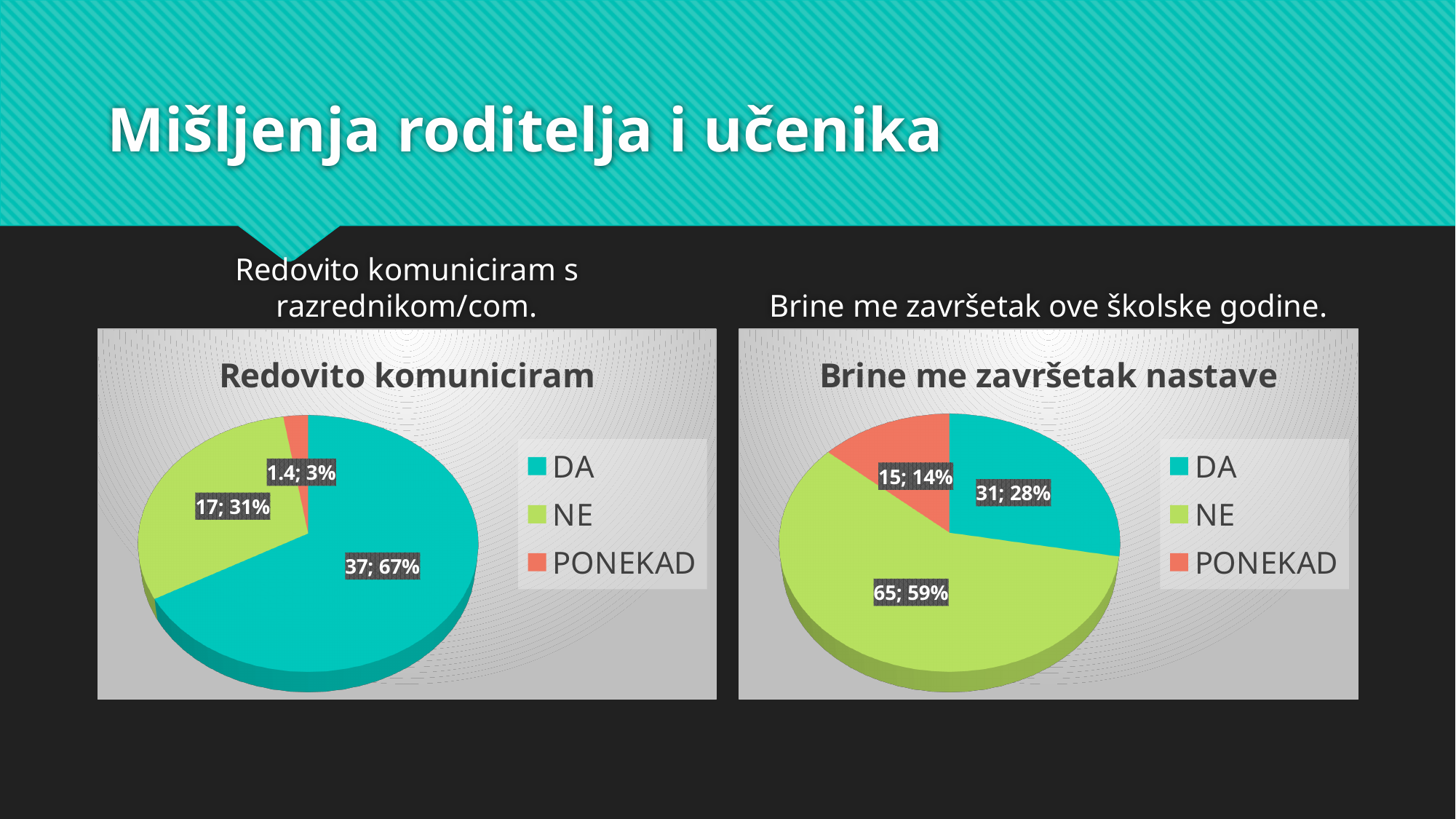
In the 'Redovito komuniciram' chart, which category has the smallest slice? PONEKAD How many entries does the legend of the 'Brine me završetak nastave' chart list? 3 How many slices does the 'Redovito komuniciram' pie chart have? 3 In the 'Brine me završetak nastave' chart, what percentage share does the PONEKAD slice have? 14% In the 'Redovito komuniciram' chart, which category has the largest slice? DA In the 'Brine me završetak nastave' chart, what is the difference between the values for NE and DA? 34 In the 'Redovito komuniciram' chart, what percentage share does the DA slice have? 67% In the 'Brine me završetak nastave' chart, what value is shown for NE? 65 In the 'Brine me završetak nastave' chart, which category has the largest slice? NE In the 'Redovito komuniciram' chart, what value is shown for NE? 17 In the 'Brine me završetak nastave' chart, which is larger, the value for DA or the value for PONEKAD? DA What kind of chart is the 'Redovito komuniciram' chart? pie chart